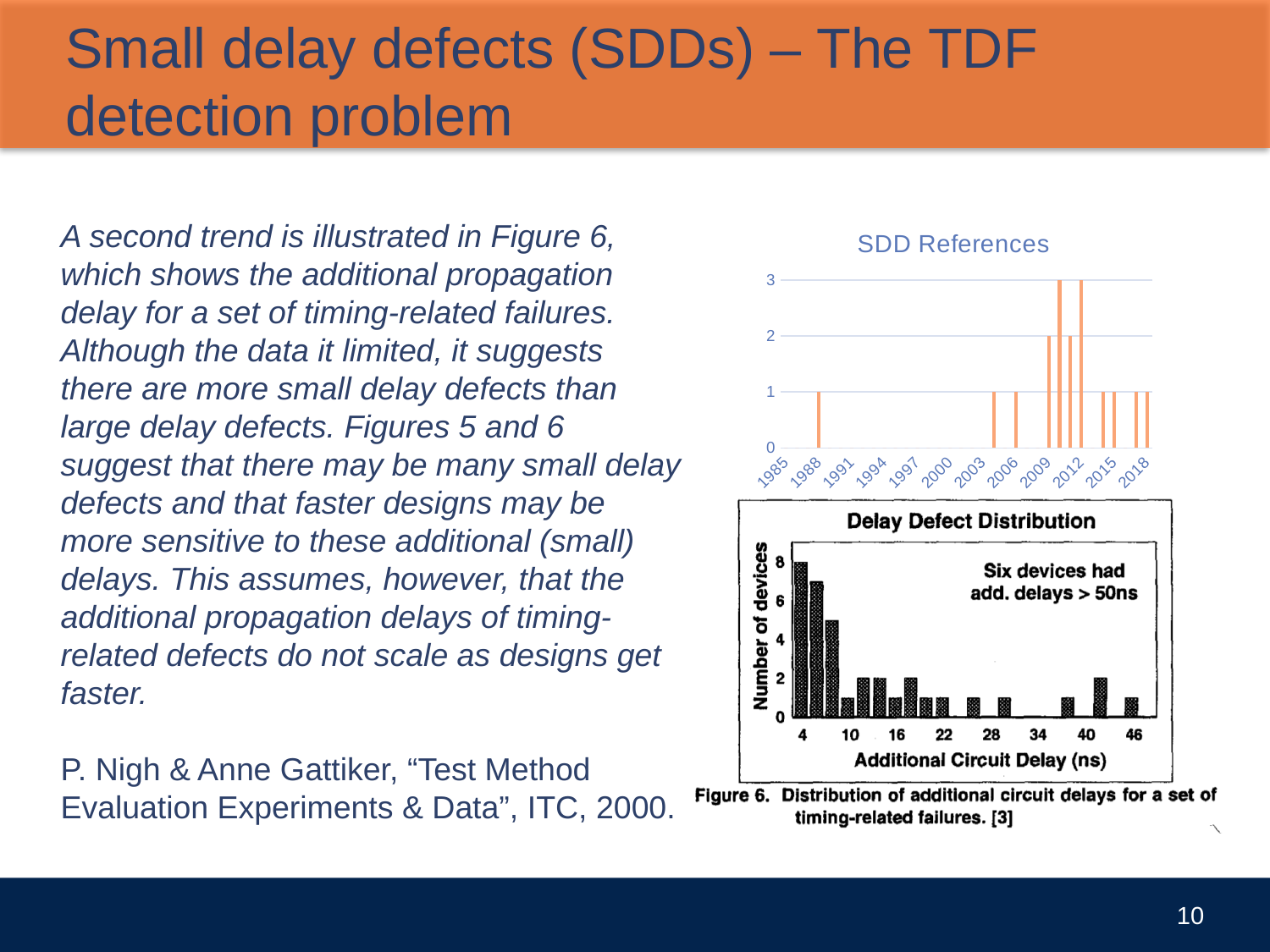
In the 'SDD References' chart, what is the earliest year that has a bar? 1988 What kind of chart is the 'Delay Defect Distribution' chart? bar chart In the 'Delay Defect Distribution' chart, do the number of devices generally rise or fall as the additional circuit delay increases? fall In the 'Delay Defect Distribution' chart, which has more devices: 4 ns or 46 ns? 4 ns In the 'SDD References' chart, what is the highest value reached by any bar? 3 In the 'SDD References' chart, what is the value for 1988? 1 In the 'Delay Defect Distribution' chart, is the number of devices at 10 ns greater or less than 4? less What is the y-axis label of the 'Delay Defect Distribution' chart? Number of devices In the 'Delay Defect Distribution' chart, how many devices had an additional circuit delay of 4 ns? 8 In the 'SDD References' chart, is the value for 1988 greater or less than 2? less What kind of chart is the 'SDD References' chart? bar chart In the 'Delay Defect Distribution' chart, which additional circuit delay has the highest number of devices? 4 ns